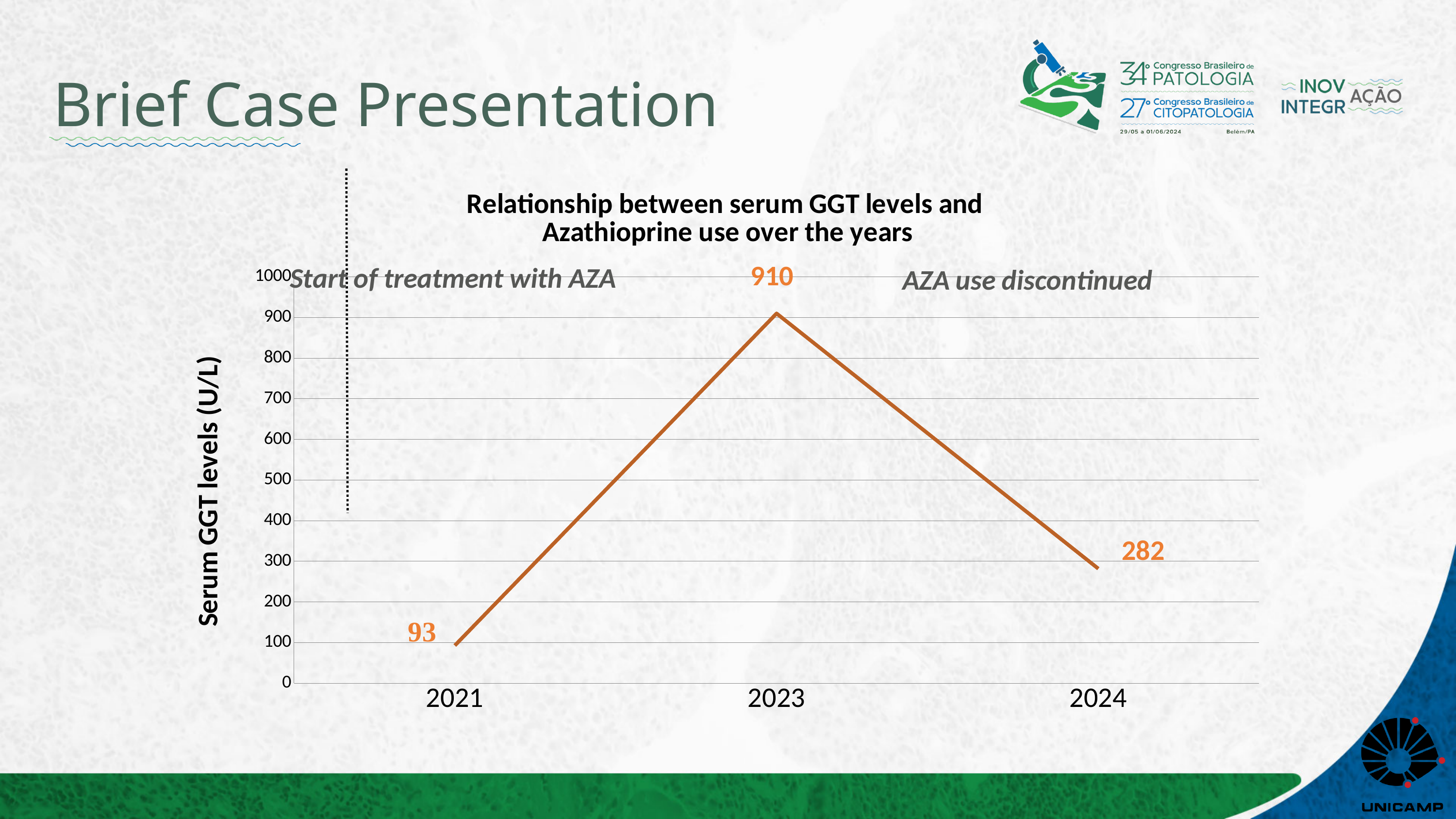
How many years are plotted on the x axis? 3 What is the serum GGT level in 2021? 93 Which year has the lowest serum GGT level? 2021 What is the difference between the serum GGT levels in 2023 and 2021? 817 Which year has the highest serum GGT level? 2023 What is the serum GGT level in 2024? 282 What is the difference between the serum GGT levels in 2023 and 2024? 628 What is the serum GGT level in 2023? 910 Which year has a higher serum GGT level, 2021 or 2024? 2024 What kind of chart is shown on the slide? Line chart What is the title of the chart? Relationship between serum GGT levels and Azathioprine use over the years Does the serum GGT level rise or fall from 2023 to 2024? Fall